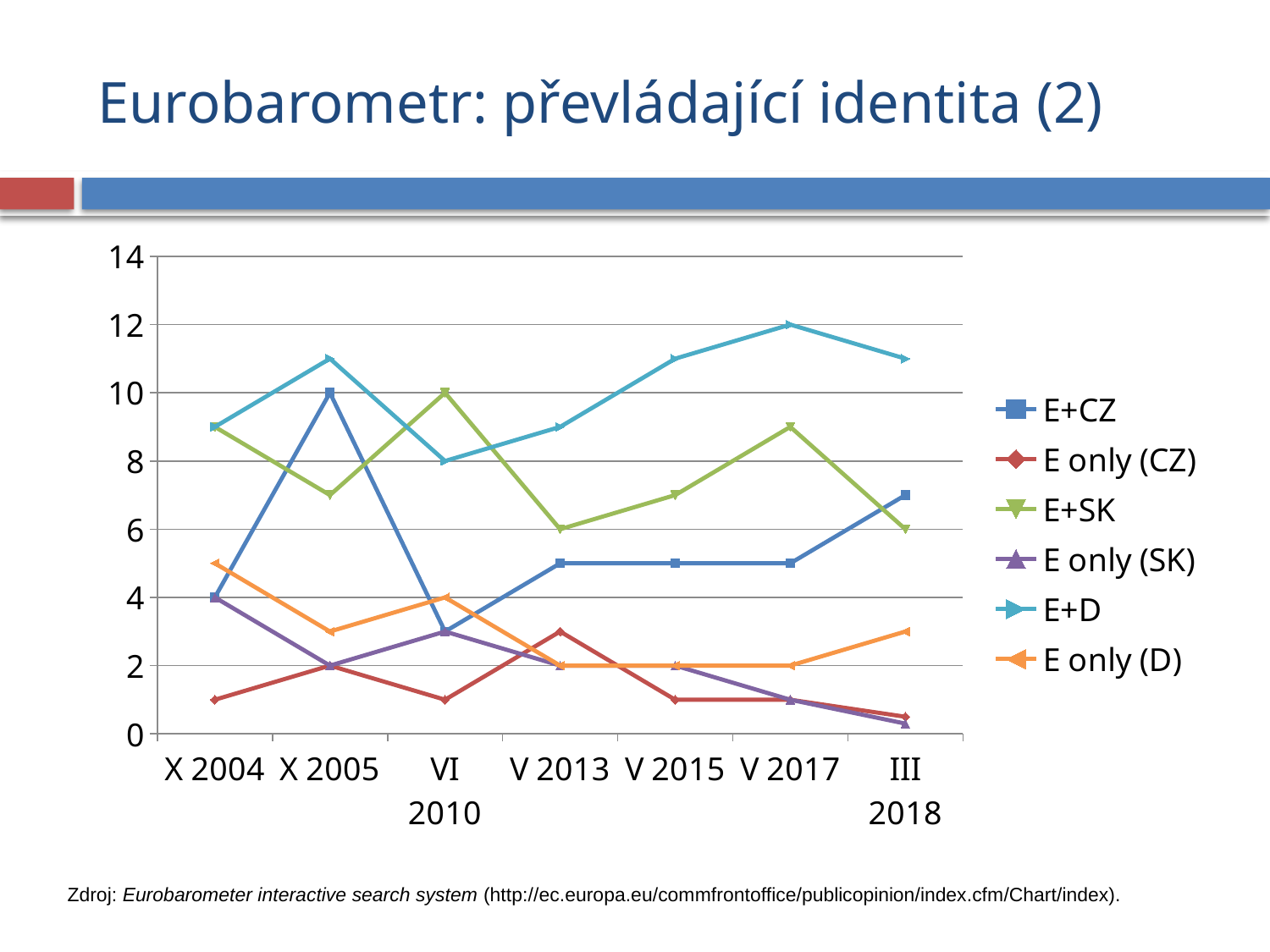
Which is larger at X 2005, E+CZ or E+SK? E+CZ What is the value of E+SK at VI 2010? 10 What kind of chart is shown on the slide? line chart What is the value of E only (D) at VI 2010? 4 What is the value of E+CZ at X 2005? 10 Which series has the highest value at V 2017? E+D Does the E+CZ series rise or fall between V 2017 and III 2018? rise How many time points are shown on the x axis? 7 How many series does the legend list? 6 What is the value of E+D at VI 2010? 8 What is the value of E+D at V 2017? 12 Is the value for E+D at V 2015 greater or less than 10? greater